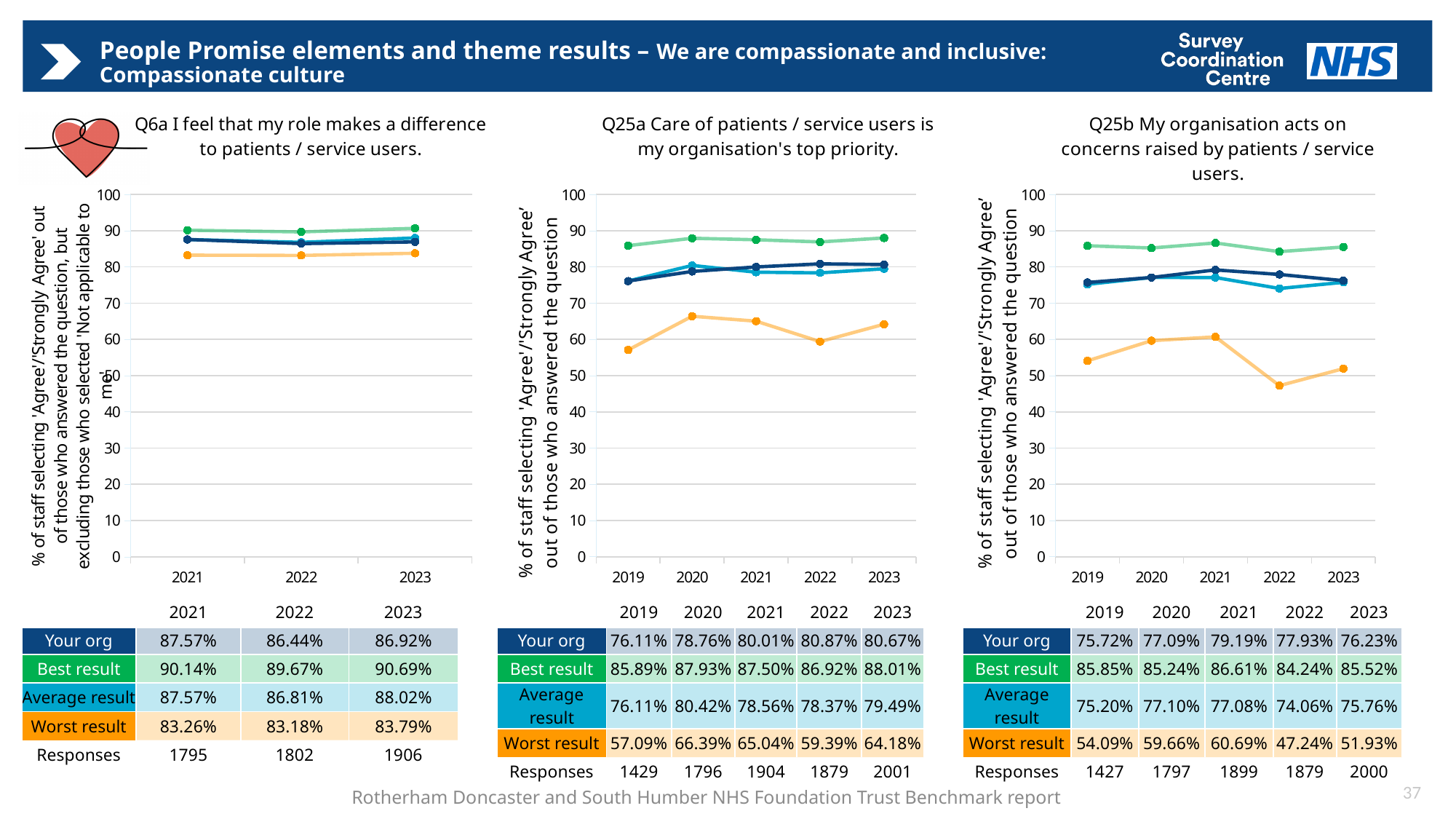
In the Q25a chart, what is the 'Worst result' value for 2020? 66.39% In the Q25a chart, does the 'Your org' line rise or fall from 2019 to 2022? Rise In the Q25b chart, what is the 'Average result' value for 2022? 74.06% In the Q25a chart, which is larger for 2021: 'Your org' or 'Average result'? Your org In the Q25b chart, is the 'Worst result' value for 2022 greater or less than 50? less What kind of chart is used for Q25a? Line chart How many years are plotted on the x axis of the Q6a chart? 3 In the Q25b chart, which year has the lowest 'Worst result' value? 2022 In the Q25a chart, which year has the highest 'Your org' value? 2022 In the Q6a chart, what is the 'Your org' value for 2023? 86.92% In the Q6a chart, what is the difference between the 'Best result' and 'Your org' values for 2023? 3.77% In the Q25b chart, what is the difference between the 'Best result' and 'Worst result' values for 2023? 33.59%